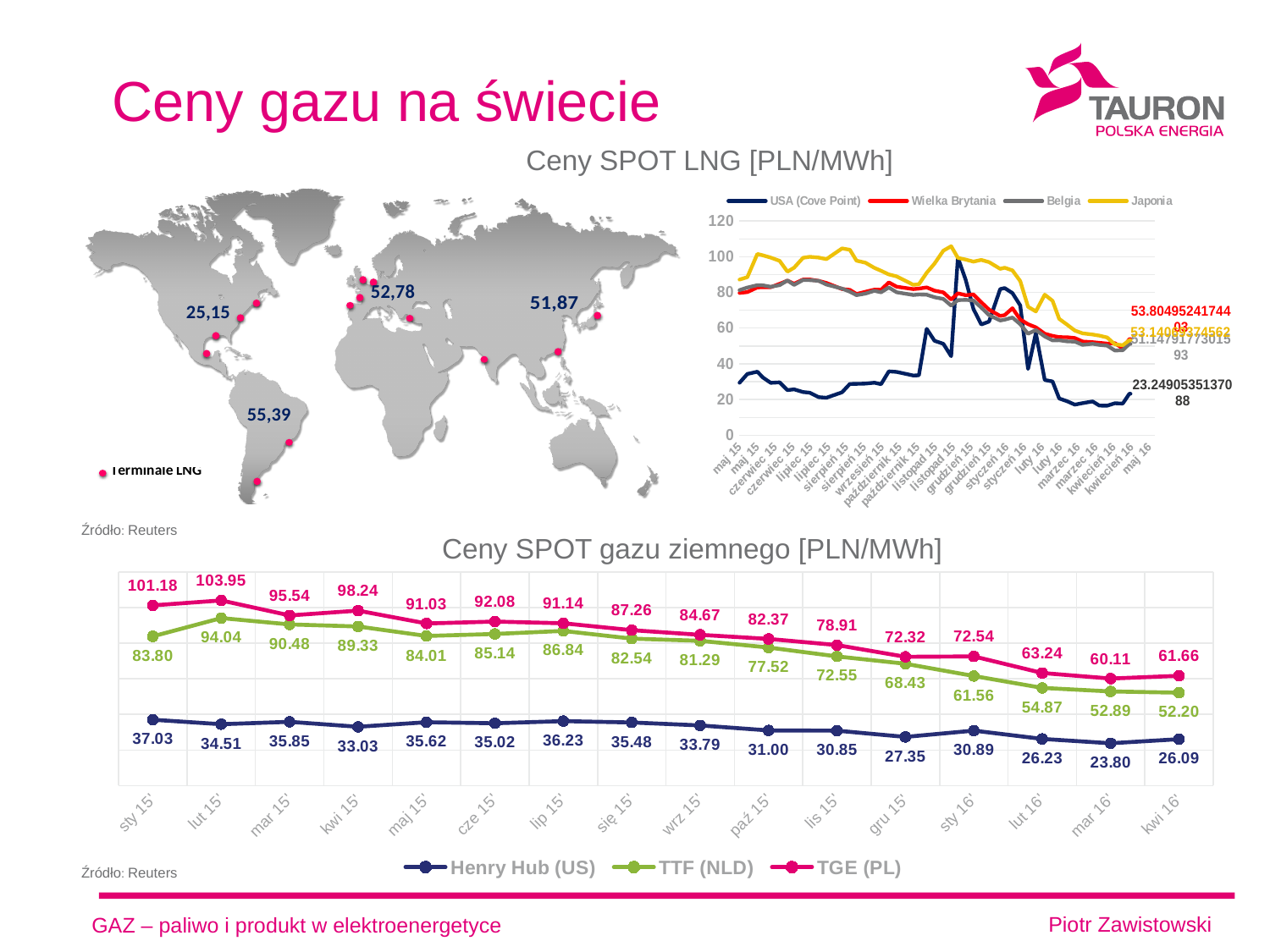
In the chart titled "Ceny SPOT gazu ziemnego [PLN/MWh]", what is the Henry Hub (US) value for mar 16'? 23.80 In the chart titled "Ceny SPOT gazu ziemnego [PLN/MWh]", in which month is the TGE (PL) value highest? lut 15' In the chart titled "Ceny SPOT gazu ziemnego [PLN/MWh]", what is the TTF (NLD) value for lip 15'? 86.84 In the chart titled "Ceny SPOT gazu ziemnego [PLN/MWh]", how many series does the legend list? 3 In the chart titled "Ceny SPOT gazu ziemnego [PLN/MWh]", what is the TGE (PL) value for sty 15'? 101.18 In the chart titled "Ceny SPOT LNG [PLN/MWh]", how many series does the legend list? 4 What kind of chart is the chart titled "Ceny SPOT LNG [PLN/MWh]"? line chart In the chart titled "Ceny SPOT gazu ziemnego [PLN/MWh]", which is larger for lut 15': TTF (NLD) or Henry Hub (US)? TTF (NLD) In the chart titled "Ceny SPOT gazu ziemnego [PLN/MWh]", in which month is the Henry Hub (US) value lowest? mar 16' In the chart titled "Ceny SPOT gazu ziemnego [PLN/MWh]", does the TTF (NLD) series generally rise or fall from lut 15' to kwi 16'? fall In the chart titled "Ceny SPOT gazu ziemnego [PLN/MWh]", what is the difference between the TGE (PL) and TTF (NLD) values for kwi 16'? 9.46 In the chart titled "Ceny SPOT gazu ziemnego [PLN/MWh]", how many months are shown on the x axis? 16